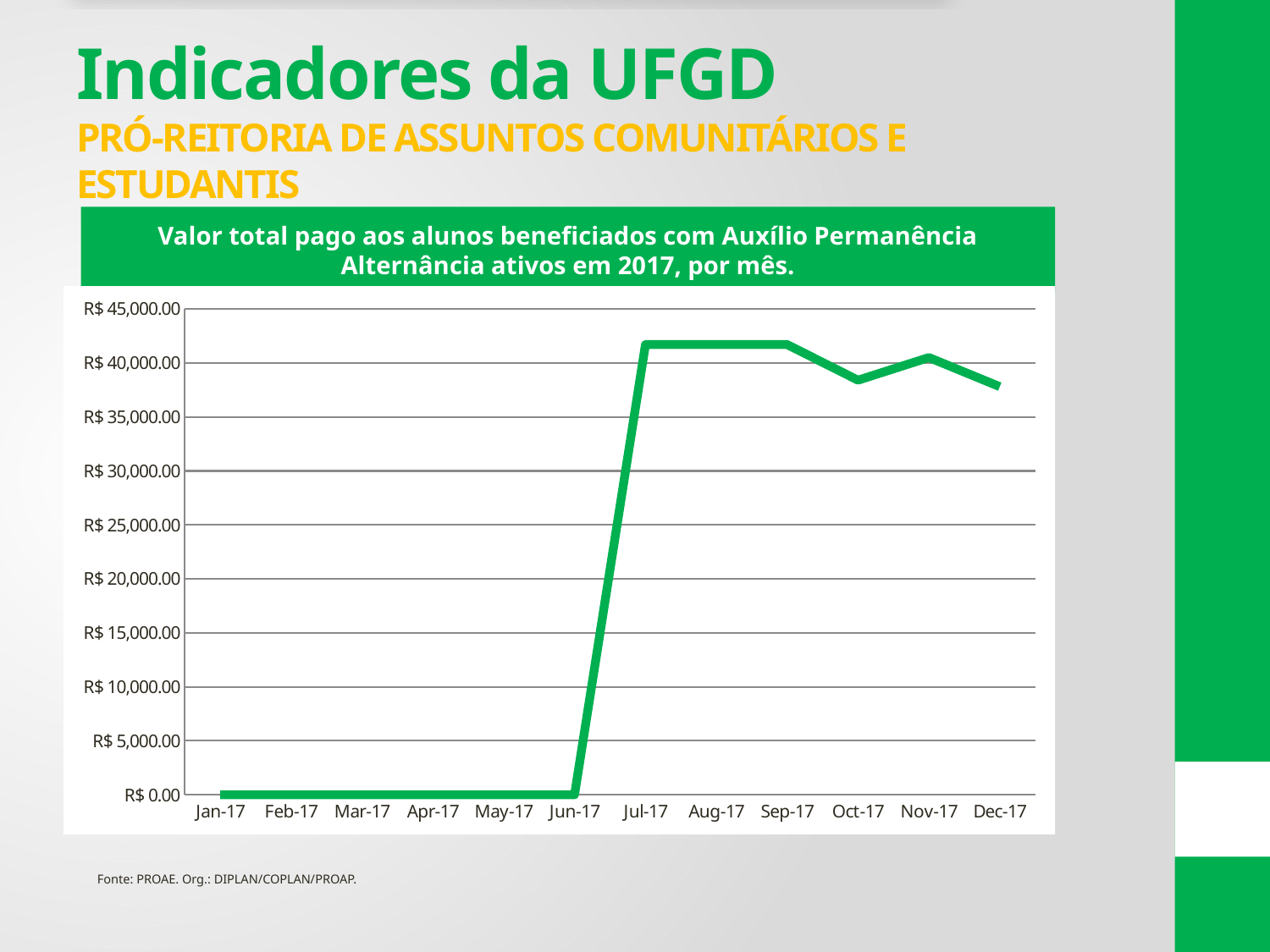
Is the value for Oct-17 greater or less than R$ 40,000.00? less How many months show a value of R$ 0.00? 6 What kind of chart is shown on the slide? line chart Which month has the larger value, Jun-17 or Jul-17? Jul-17 What is the value for Jan-17? R$ 0.00 Is the value for Aug-17 greater or less than R$ 35,000.00? greater Is the value for Dec-17 greater or less than R$ 40,000.00? less How many months are plotted along the x axis? 12 What is the value for Jun-17? R$ 0.00 Does the value rise or fall from Sep-17 to Oct-17? fall Which month has the larger value, Sep-17 or Oct-17? Sep-17